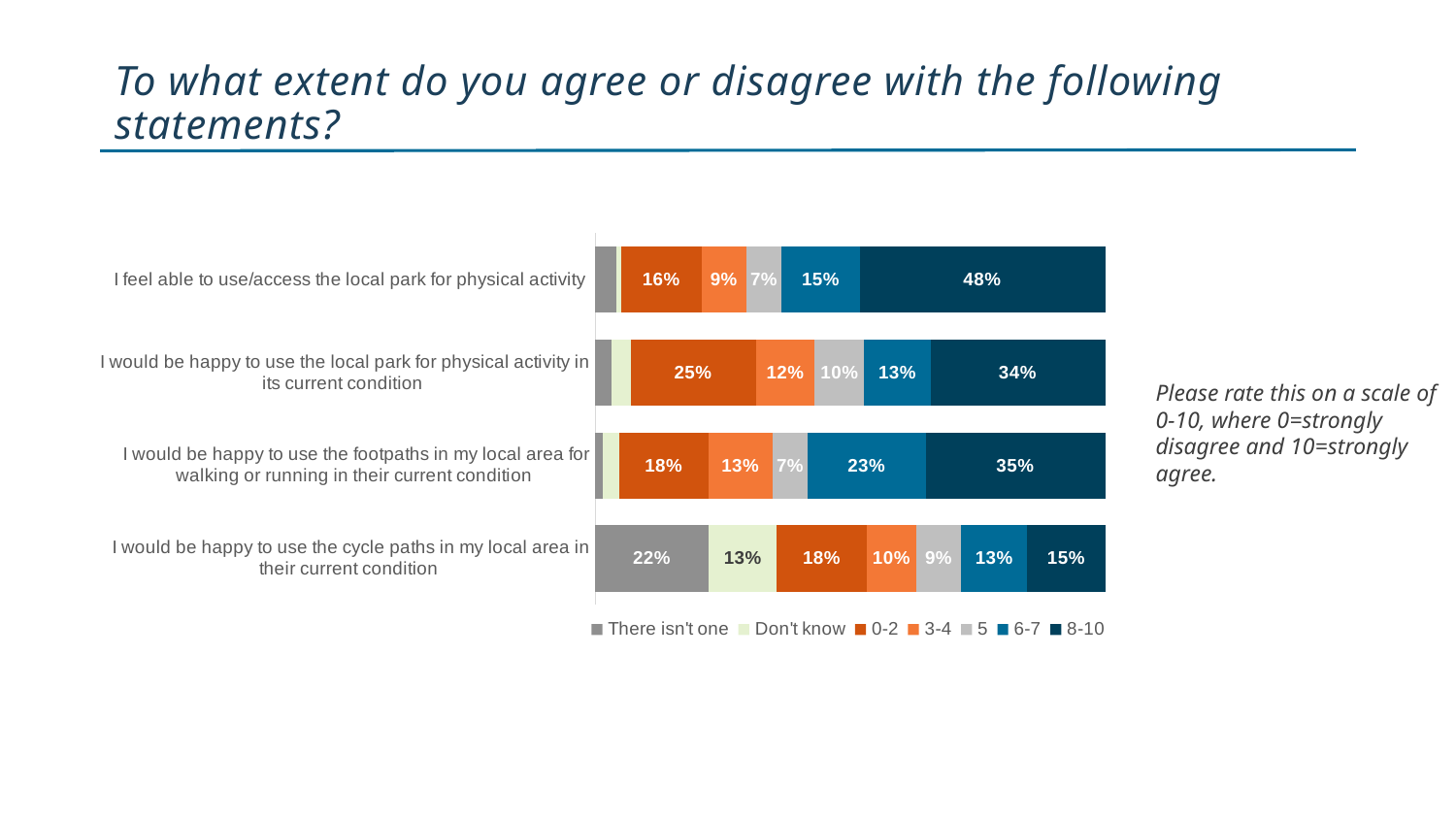
Which statement has the highest 8-10 value? I feel able to use/access the local park for physical activity What is the 8-10 value for 'I feel able to use/access the local park for physical activity'? 48% What is the total of all labelled segments for 'I would be happy to use the cycle paths in my local area in their current condition'? 100% How many statements (categories) are plotted in the chart? 4 Which is larger: the 0-2 value for the local park current condition statement or the 0-2 value for the footpaths statement? The local park current condition statement (25%) What type of chart is shown on the slide? Stacked bar chart What is the 'There isn't one' value for 'I would be happy to use the cycle paths in my local area in their current condition'? 22% What is the difference between the 8-10 values for the local park access statement (48%) and the cycle paths statement (15%)? 33 percentage points How many series does the legend list? 7 What is the 0-2 value for 'I would be happy to use the local park for physical activity in its current condition'? 25% Which statement has the lowest 8-10 value? I would be happy to use the cycle paths in my local area in their current condition What is the 6-7 value for 'I would be happy to use the footpaths in my local area for walking or running in their current condition'? 23%